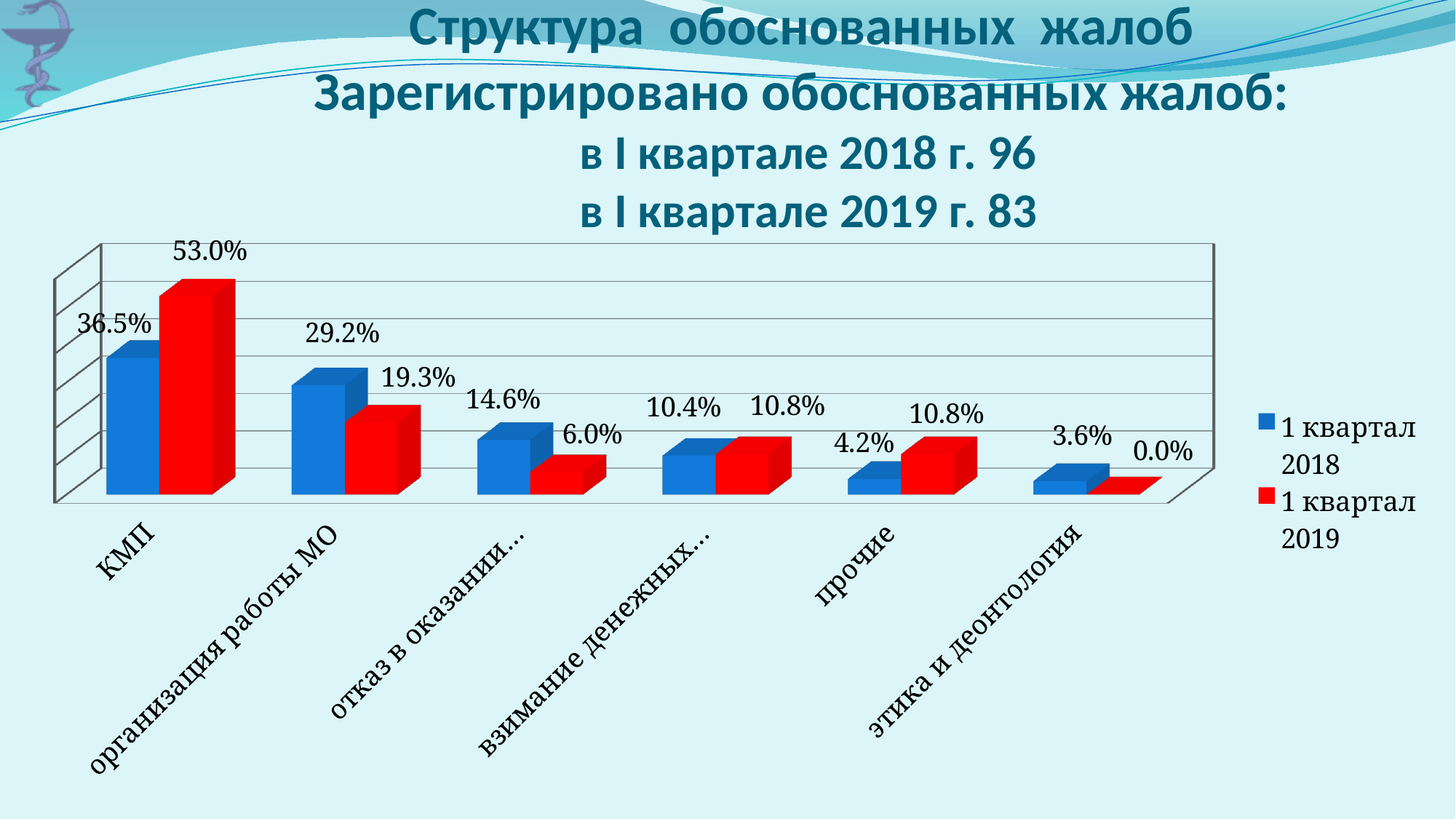
What is the value for прочие in the 1 квартал 2018 series? 4.2% How many series does the legend list? 2 How many categories are shown on the x axis of the chart? 6 What kind of chart is shown on the slide? bar chart What is the value for КМП in the 1 квартал 2019 series? 53.0% Which category has the highest value in the 1 квартал 2019 series? КМП For организация работы МО, which series has the larger value: 1 квартал 2018 or 1 квартал 2019? 1 квартал 2018 What is the difference between the 1 квартал 2019 and 1 квартал 2018 values for КМП? 16.5% What is the value for организация работы МО in the 1 квартал 2019 series? 19.3% What is the value for КМП in the 1 квартал 2018 series? 36.5% What is the value for этика и деонтология in the 1 квартал 2019 series? 0.0% Which category has the lowest value in the 1 квартал 2018 series? этика и деонтология